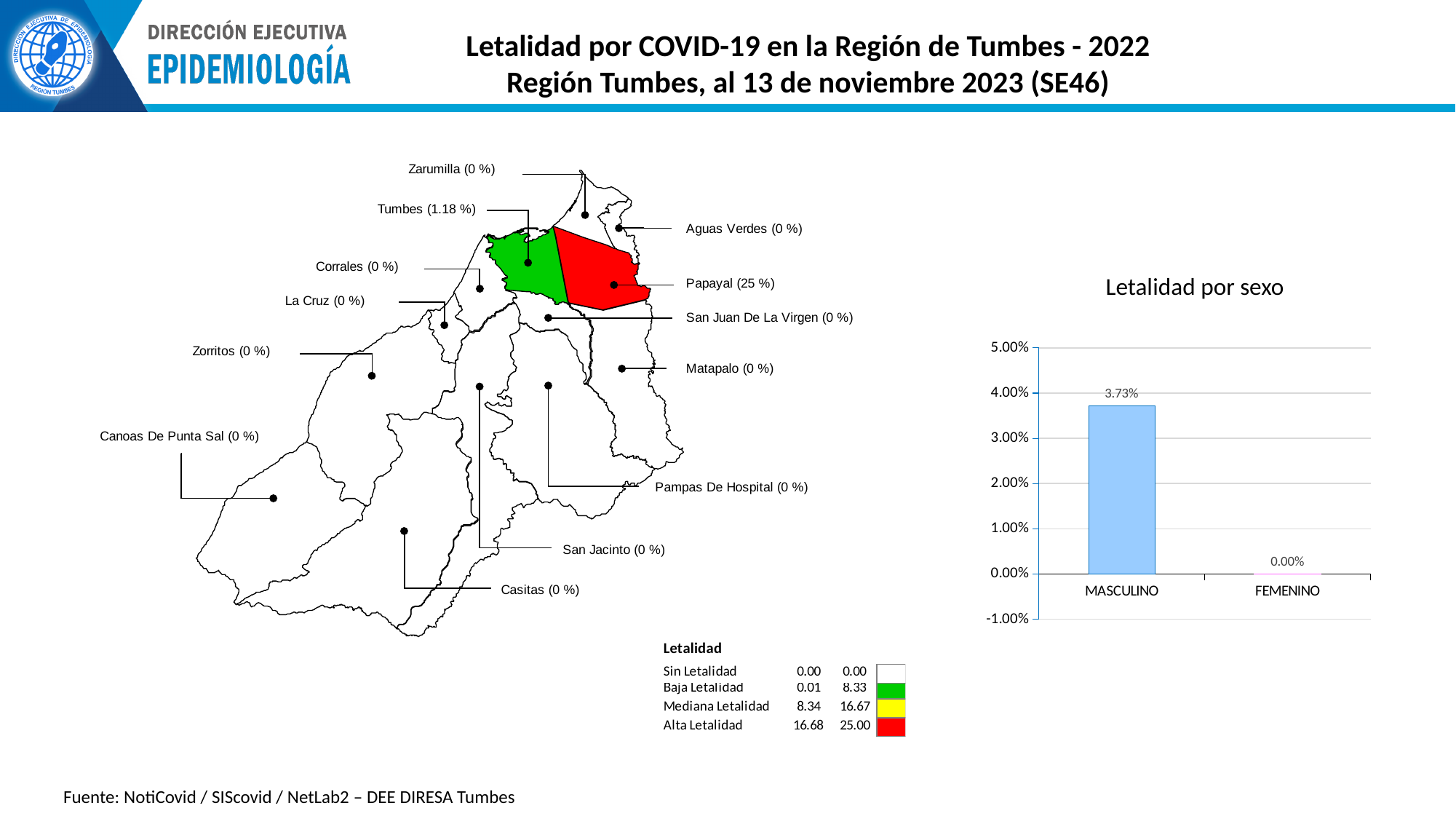
In the 'Letalidad por sexo' chart, which category has the highest value? MASCULINO In the 'Letalidad por sexo' chart, what is the value for MASCULINO? 3.73% What is the title of the chart on the right side of the slide? Letalidad por sexo On the map, which district has the highest lethality value? Papayal (25 %) In the 'Letalidad por sexo' chart, which category has the lowest value? FEMENINO On the map, which district is shaded red? Papayal In the 'Letalidad por sexo' chart, what is the value for FEMENINO? 0.00% In the 'Letalidad por sexo' chart, how many categories are shown on the x axis? 2 In the 'Letalidad por sexo' chart, what is the difference between the MASCULINO and FEMENINO values? 3.73% In the 'Letalidad por sexo' chart, is the value for MASCULINO greater or less than 3.00%? greater On the map, what is the lethality value shown for Tumbes? 1.18 % What kind of chart is 'Letalidad por sexo'? bar chart